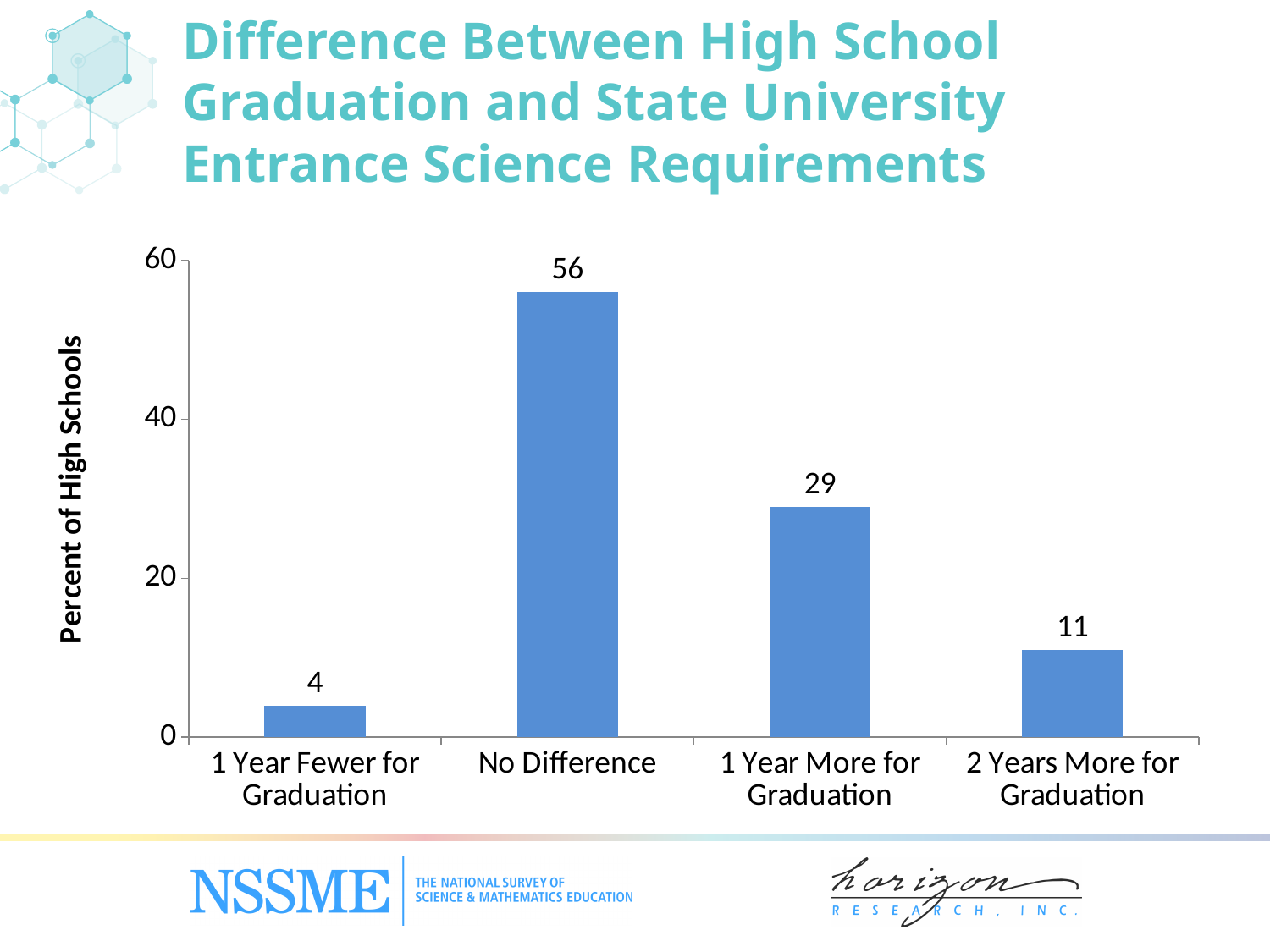
What percent of high schools have no difference between graduation and state university entrance science requirements? 56 Which is larger: the value for '1 Year More for Graduation' or '2 Years More for Graduation'? 1 Year More for Graduation What is the value for '1 Year Fewer for Graduation'? 4 Which category has the highest percent of high schools? No Difference How many categories are shown on the x axis? 4 What is the difference between the values for '2 Years More for Graduation' and '1 Year Fewer for Graduation'? 7 What is the label of the y axis? Percent of High Schools What is the difference between the values for 'No Difference' and '1 Year More for Graduation'? 27 Is the value for 'No Difference' greater or less than 40? greater What kind of chart is shown on the slide? bar chart Which category has the lowest percent of high schools? 1 Year Fewer for Graduation What is the value for '2 Years More for Graduation'? 11